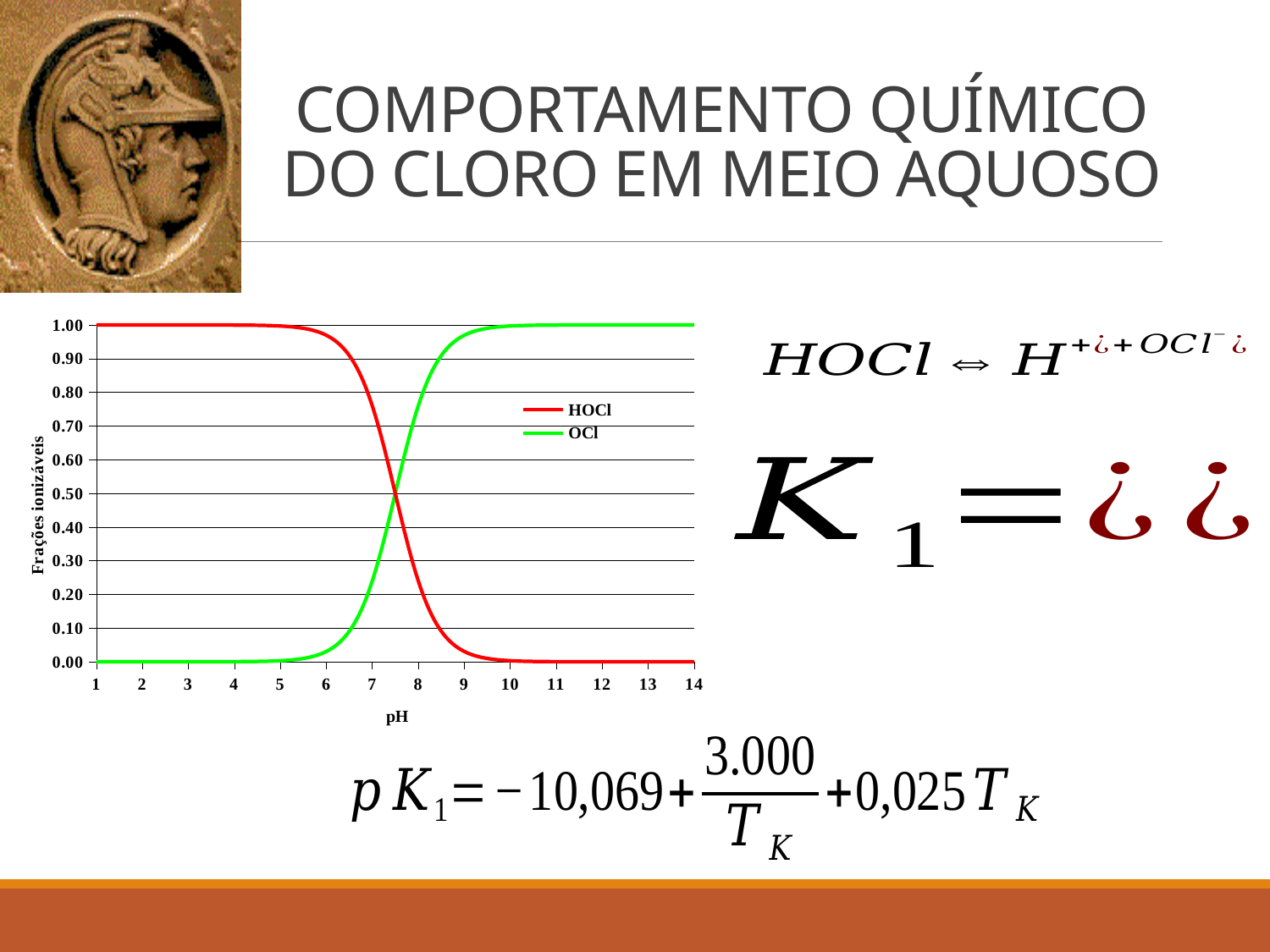
What is the label of the x axis of the chart? pH At pH 9, which series has the larger value, HOCl or OCl? OCl What are the two series named in the chart legend? HOCl and OCl Does the HOCl series rise or fall as pH increases? fall At pH 7, which series has the larger value, HOCl or OCl? HOCl How many pH values are marked along the x axis of the chart? 14 What kind of chart is shown on the slide? line chart Is the value of the HOCl series at pH 9 greater or less than 0.10? less Is the value of the OCl series at pH 6 greater or less than 0.10? less How many series does the chart legend list? 2 Does the OCl series rise or fall as pH increases? rise Is the value of the HOCl series at pH 5 greater or less than 0.90? greater